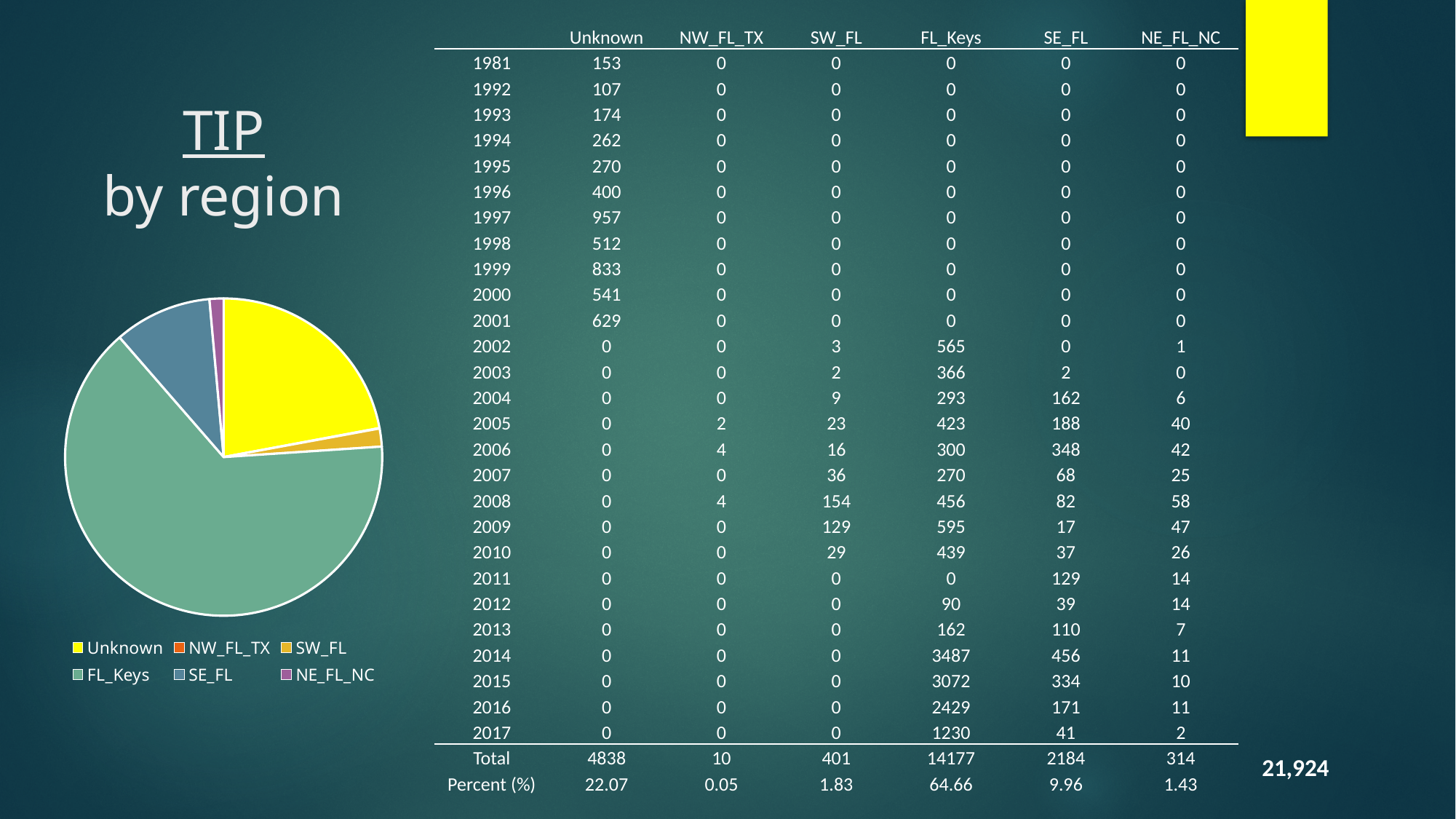
Which region has the largest slice of the pie chart? FL_Keys What is the total value for SW_FL shown in the table? 401 What is the title of the slide containing the pie chart? TIP by region Which slice is larger in the pie chart, Unknown or SE_FL? Unknown How many slices does the pie chart have? 5 How many entries does the pie chart's legend list? 6 Which slice is larger in the pie chart, SE_FL or NE_FL_NC? SE_FL What colour is the FL_Keys slice in the pie chart? green According to the Percent (%) row, what share of the pie does Unknown represent? 22.07 What is the total value for SE_FL shown in the table? 2184 What kind of chart is shown on the slide? pie chart According to the Percent (%) row, what share of the pie does FL_Keys represent? 64.66